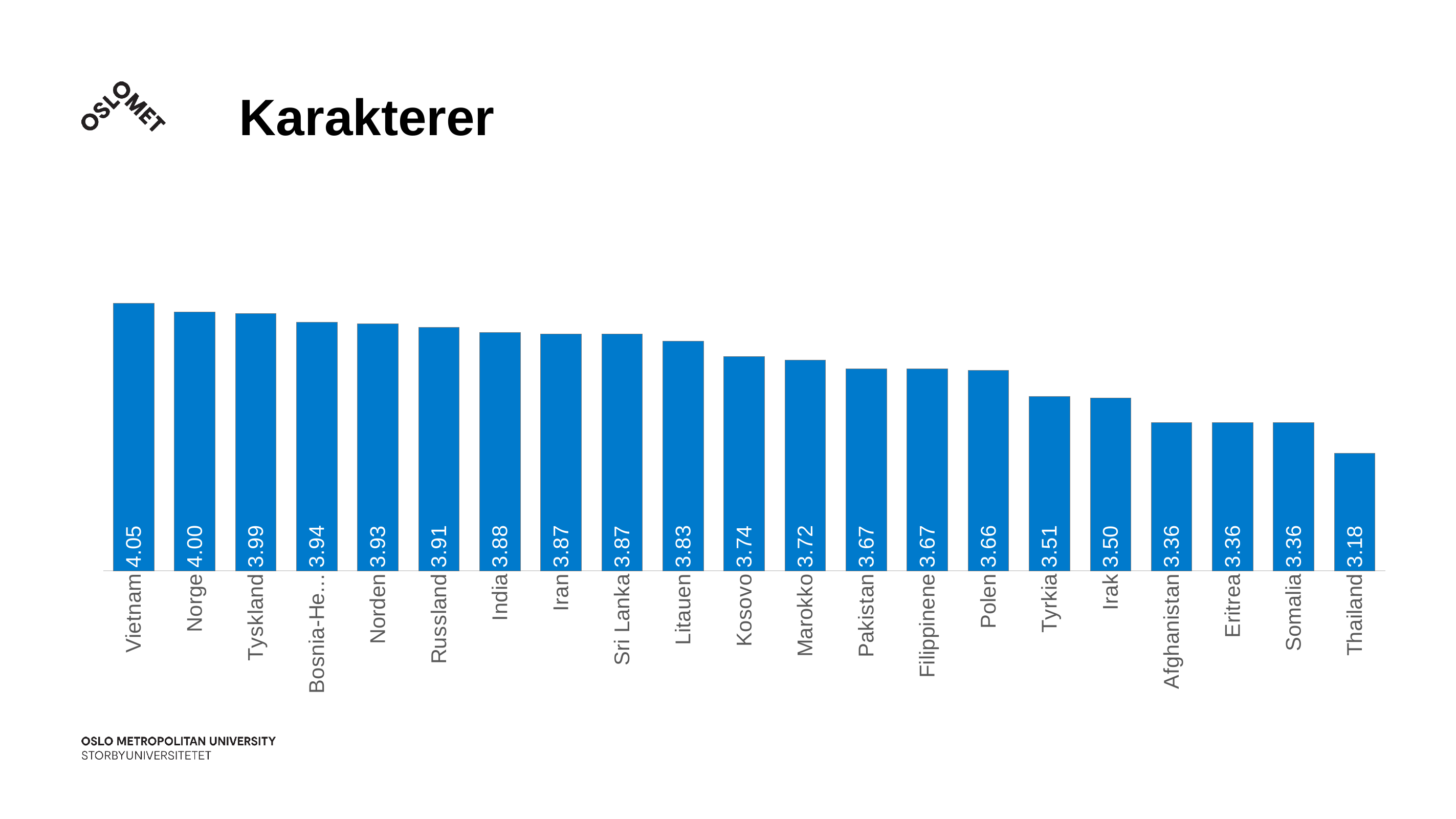
Which category has the lowest value? Thailand Which has a larger value, Litauen or Polen? Litauen What kind of chart is shown on the slide? bar chart What is the value for Pakistan? 3.67 Which category has the highest value? Vietnam What is the value for Vietnam? 4.05 How many countries/categories are shown in the chart? 21 Do the values rise or fall from left to right along the x axis? fall What is the title of the chart? Karakterer What is the difference between the values for Kosovo and Tyrkia? 0.23 What is the difference between the values for Norge and Thailand? 0.82 What is the value for Irak? 3.50